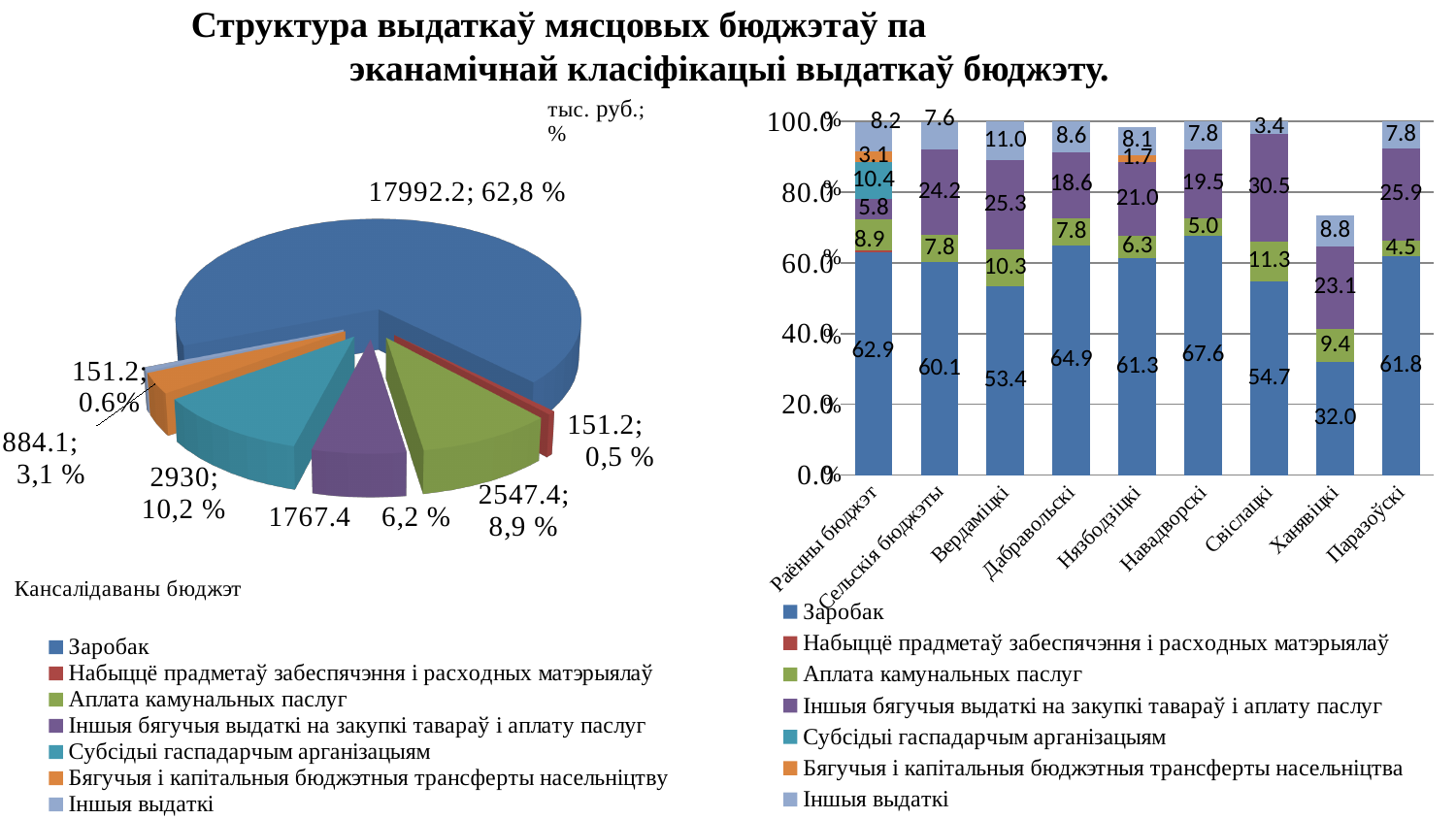
On the stacked bar chart, which budget has the lowest Заробак value? Ханявіцкі On the pie chart, what share is shown for Субсідыі гаспадарчым арганізацыям? 10,2 % How many budget categories are shown on the x axis of the stacked bar chart? 9 On the stacked bar chart, what is the difference between the Заробак values for Навадворскі and Ханявіцкі? 35.6 On the stacked bar chart, which has the larger Аплата камунальных паслуг value: Свіслацкі or Паразоўскі? Свіслацкі On the pie chart, which category has the largest slice? Заробак What kind of chart is the left chart on the slide? Pie chart On the pie chart (Кансалідаваны бюджэт), what value and share are shown for the Заробак slice? 17992.2; 62,8 % How many series does the legend of the stacked bar chart list? 7 On the stacked bar chart, what is the Заробак value for Ханявіцкі? 32.0 On the stacked bar chart, which budget has the highest Заробак value? Навадворскі On the stacked bar chart, what is the value of Іншыя бягучыя выдаткі на закупкі тавараў і аплату паслуг for Свіслацкі? 30.5